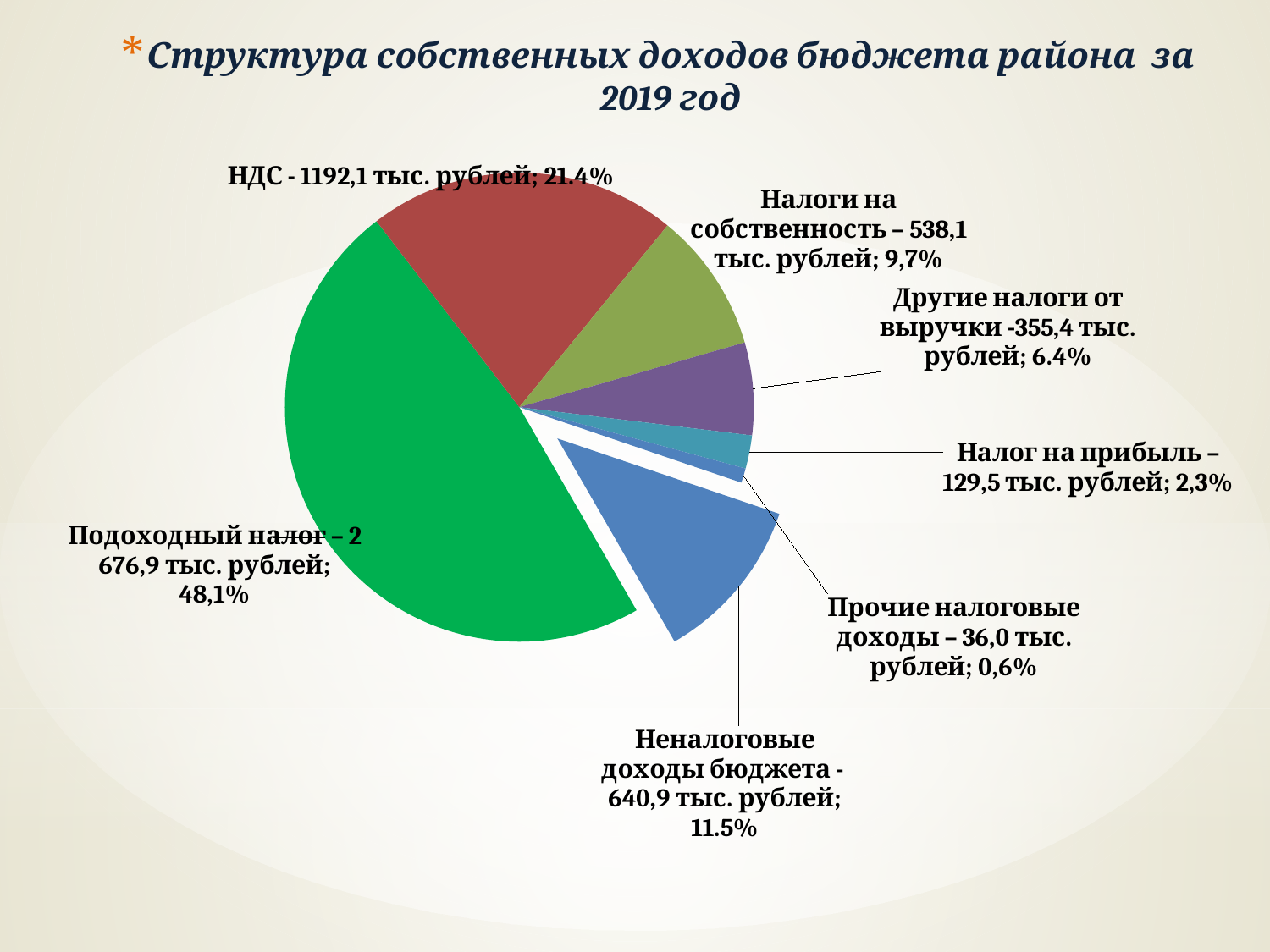
Which category has the largest share of the pie? Подоходный налог Which category has the smallest share of the pie? Прочие налоговые доходы What share of the pie does Налог на прибыль represent? 2,3% What is the difference between the values for НДС and Неналоговые доходы бюджета? 551,2 тыс. рублей What kind of chart is shown on the slide? pie chart How many slices does the pie chart have? 7 What colour is the slice for Подоходный налог? green What is the value for Неналоговые доходы бюджета? 640,9 тыс. рублей What share of the pie does НДС represent? 21.4% What is the title of the chart? Структура собственных доходов бюджета района за 2019 год What is the value for Подоходный налог? 2 676,9 тыс. рублей Which is larger, Налоги на собственность or Другие налоги от выручки? Налоги на собственность